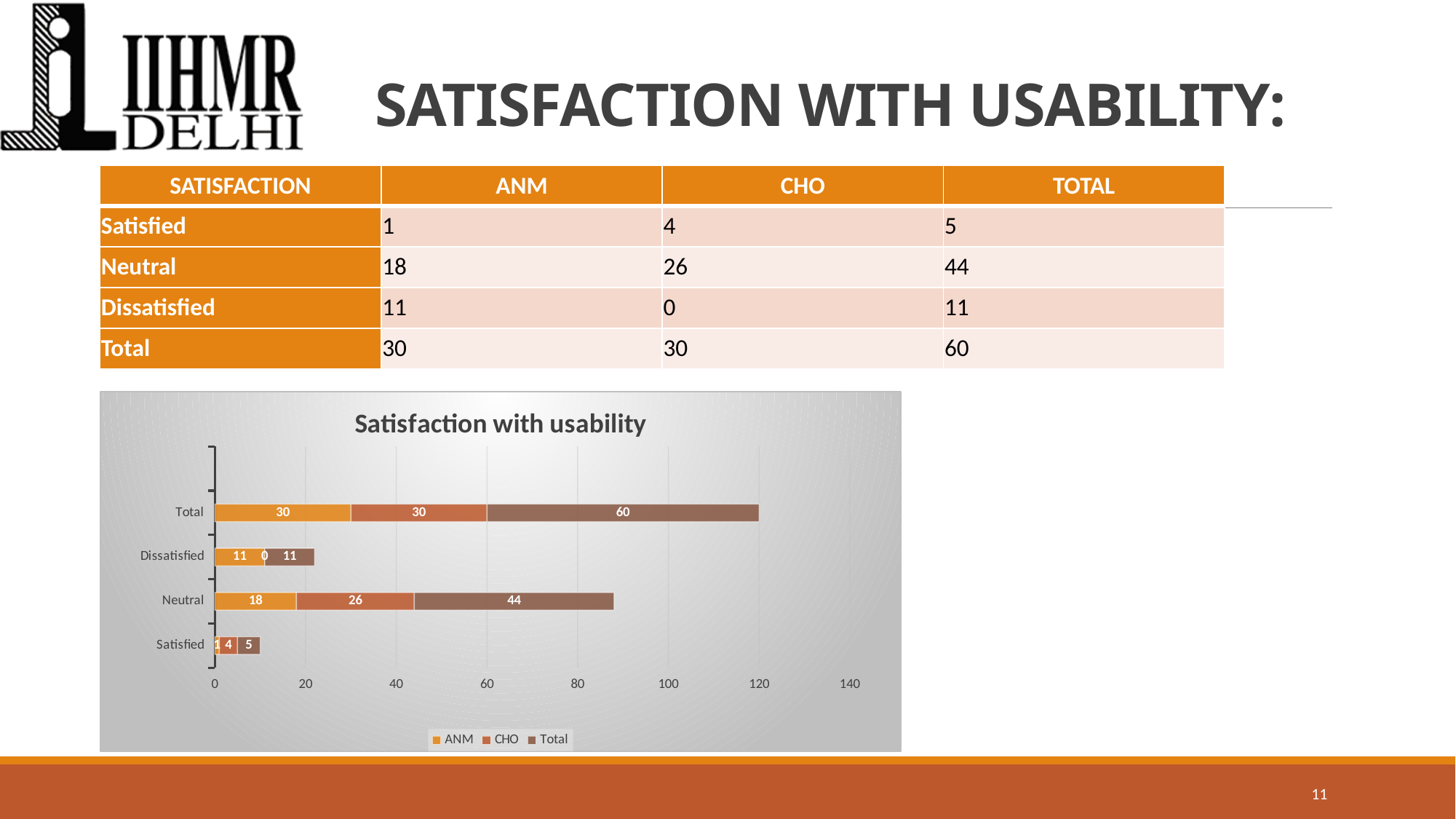
Which category has the lowest ANM value in the chart? Satisfied What is the chart's title? Satisfaction with usability What is the ANM value for Neutral in the chart? 18 How many series does the chart's legend list? 3 What is the difference between the CHO and ANM values for Neutral in the chart? 8 What is the CHO value for Dissatisfied in the chart? 0 What is the Total series value for Satisfied in the chart? 5 How many categories are shown on the chart's vertical axis? 4 What kind of chart is shown on the slide? Stacked bar chart Is the ANM value for Dissatisfied larger or smaller than the CHO value for Dissatisfied? larger What is the total length of the stacked bar for Neutral in the chart? 88 Which category has the highest CHO value in the chart? Total